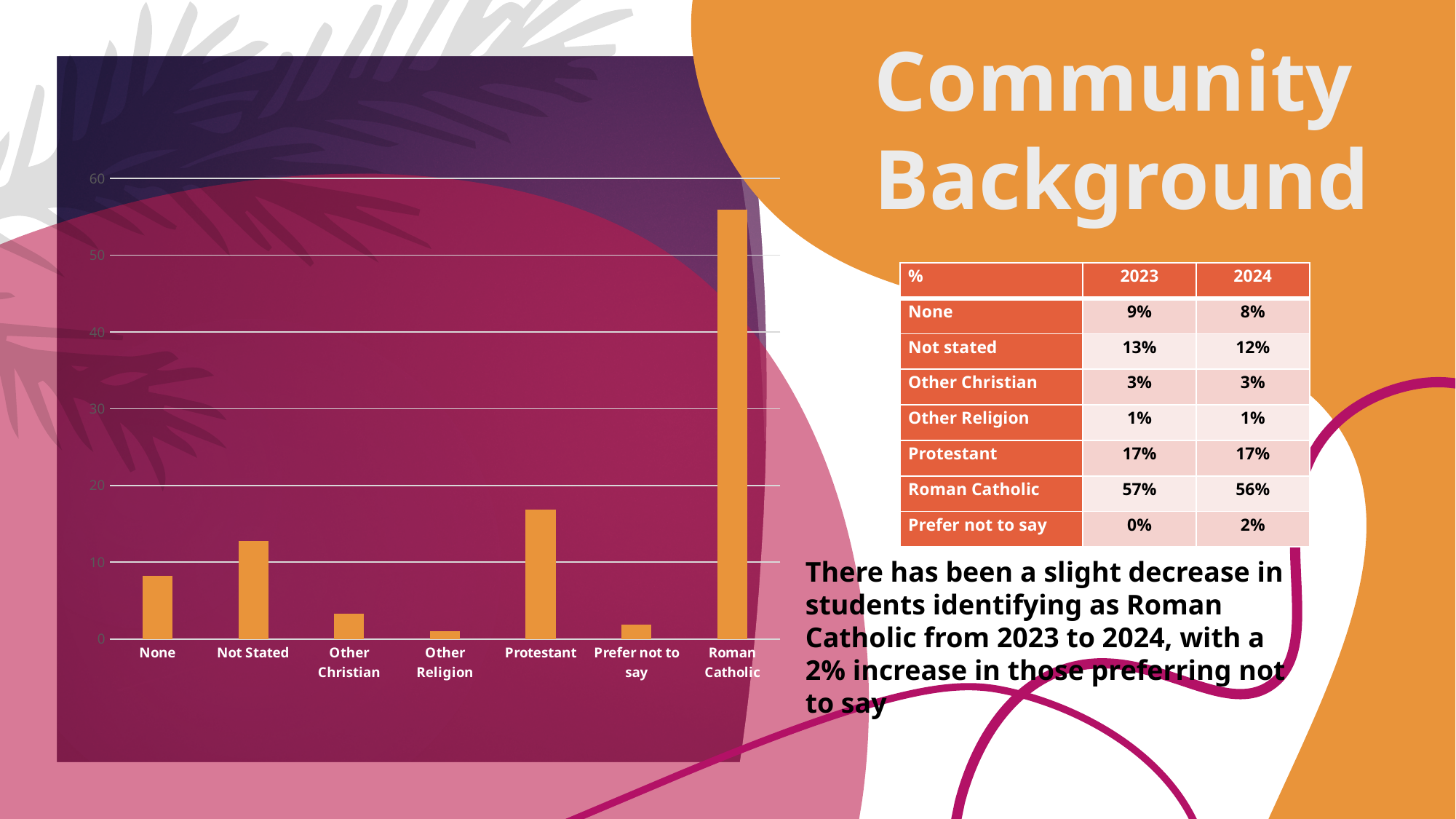
Is the value for Not Stated greater or less than 10? greater How many categories are shown on the x axis of the chart? 7 Which is larger in the chart, the value for Protestant or the value for Not Stated? Protestant Is the value for Protestant greater or less than 10? greater Is the value for Roman Catholic greater or less than 50? greater What kind of chart is shown on the slide? bar chart Which category has the highest bar in the chart? Roman Catholic Which is larger in the chart, the value for None or the value for Other Christian? None What is the highest value shown on the chart's vertical axis? 60